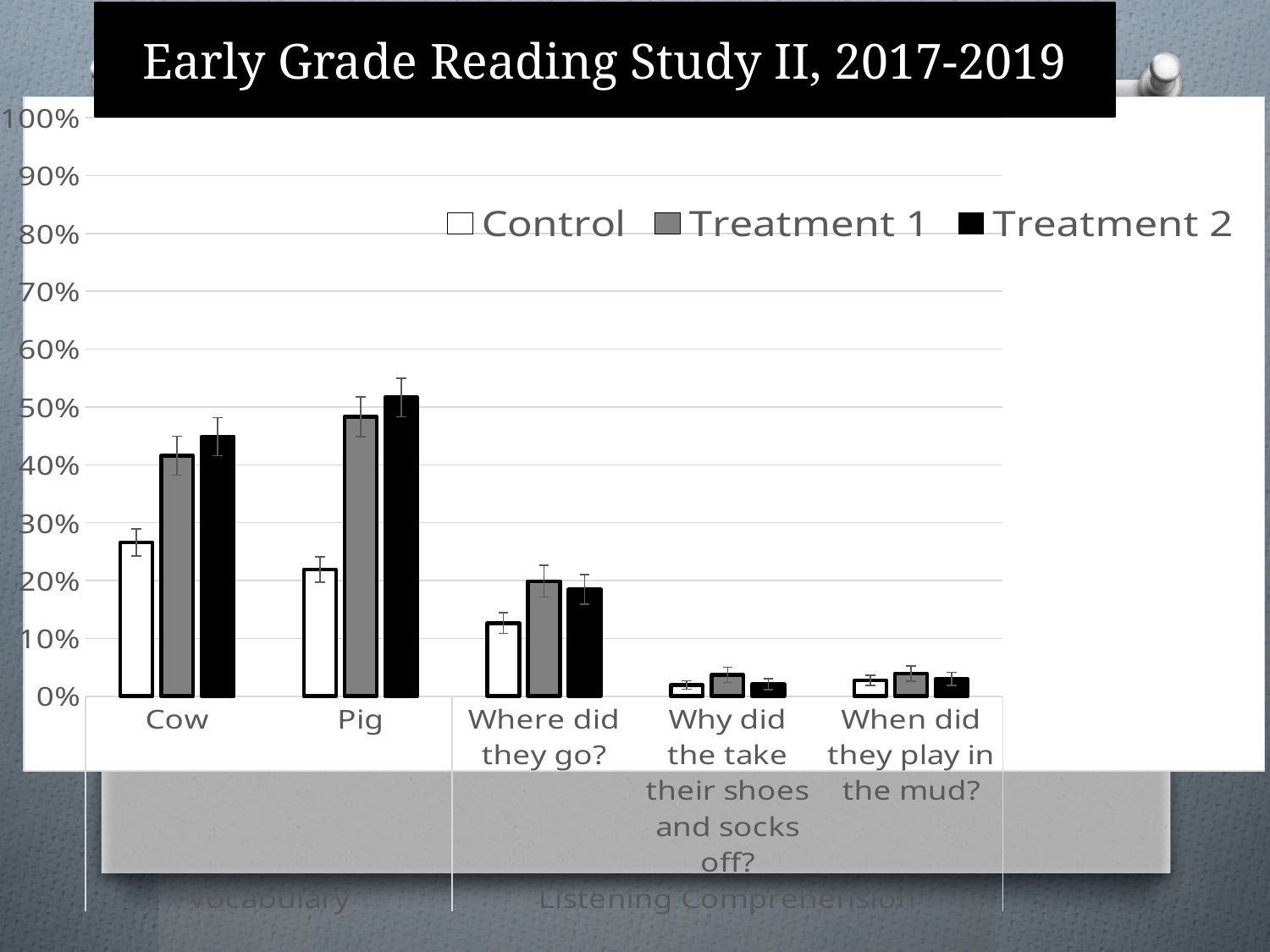
Which is larger for the Control series, the Cow value or the Pig value? Cow Is the value for Control in the 'Where did they go?' category greater or less than 10%? greater Is the value for Control in the Cow category greater or less than 30%? less How many categories are shown along the x axis? 5 Which is larger in the Pig category, the Control value or the Treatment 1 value? Treatment 1 What is the title of the chart? Early Grade Reading Study II, 2017-2019 Which series is shown with black bars? Treatment 2 What kind of chart is shown on the slide? bar chart Is the value for Treatment 1 in the Cow category greater or less than 40%? greater How many series does the legend list? 3 Which category has the highest Treatment 2 value? Pig